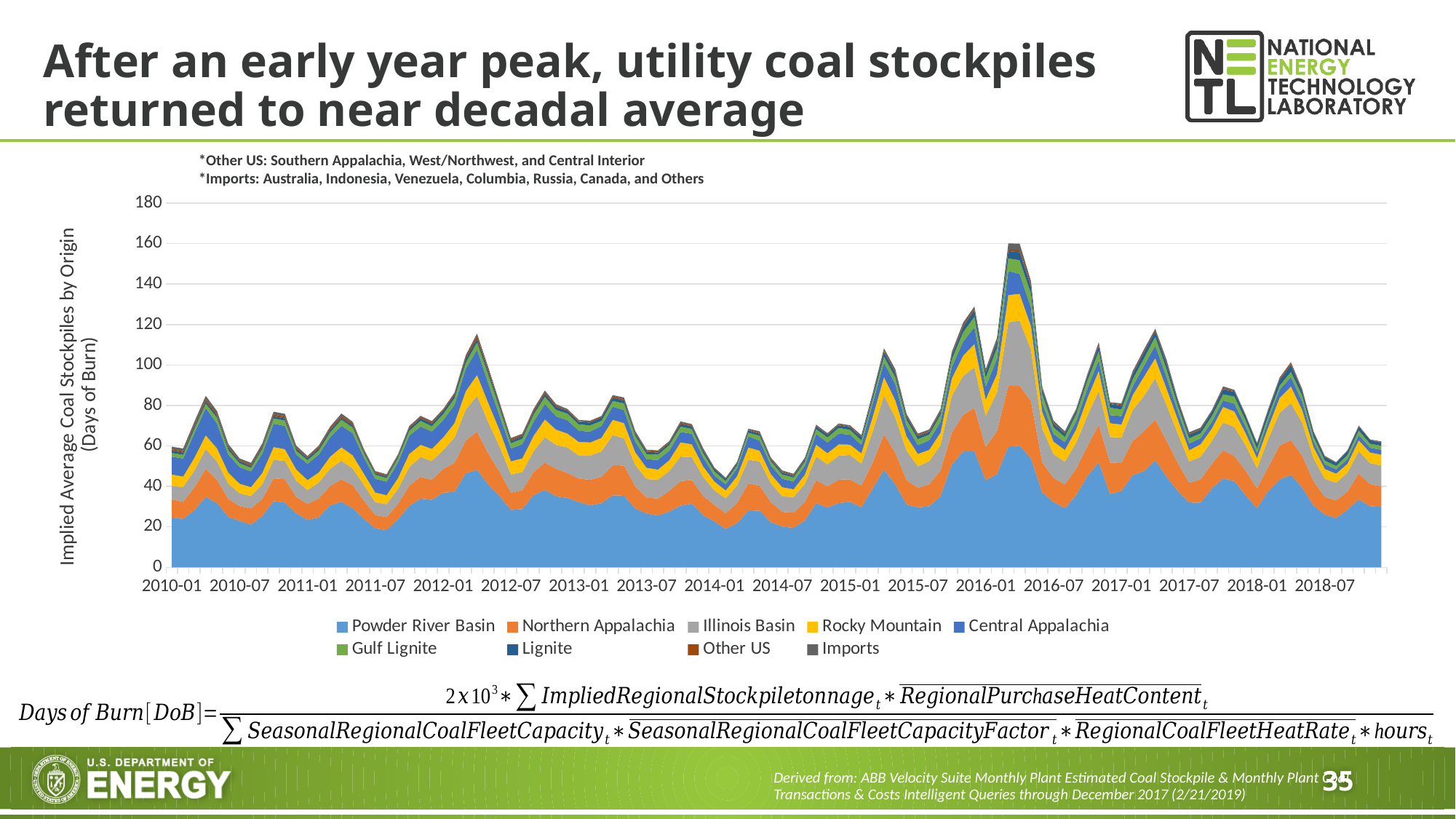
What is the label on the vertical axis? Implied Average Coal Stockpiles by Origin (Days of Burn) Which series occupies a larger area of the chart, Powder River Basin or Lignite? Powder River Basin In which year does the stacked total reach its highest peak? 2016 Is the stacked total at 2014-01 greater or less than 60? less How many series does the legend list? 9 How many date labels are shown on the horizontal axis? 18 What kind of chart is shown on the slide? stacked area chart Between 2018-01 and 2018-07, does the stacked total rise or fall? fall What is the highest value shown on the vertical axis? 180 What is the first date label on the horizontal axis? 2010-01 Which colour represents Powder River Basin in the legend? blue